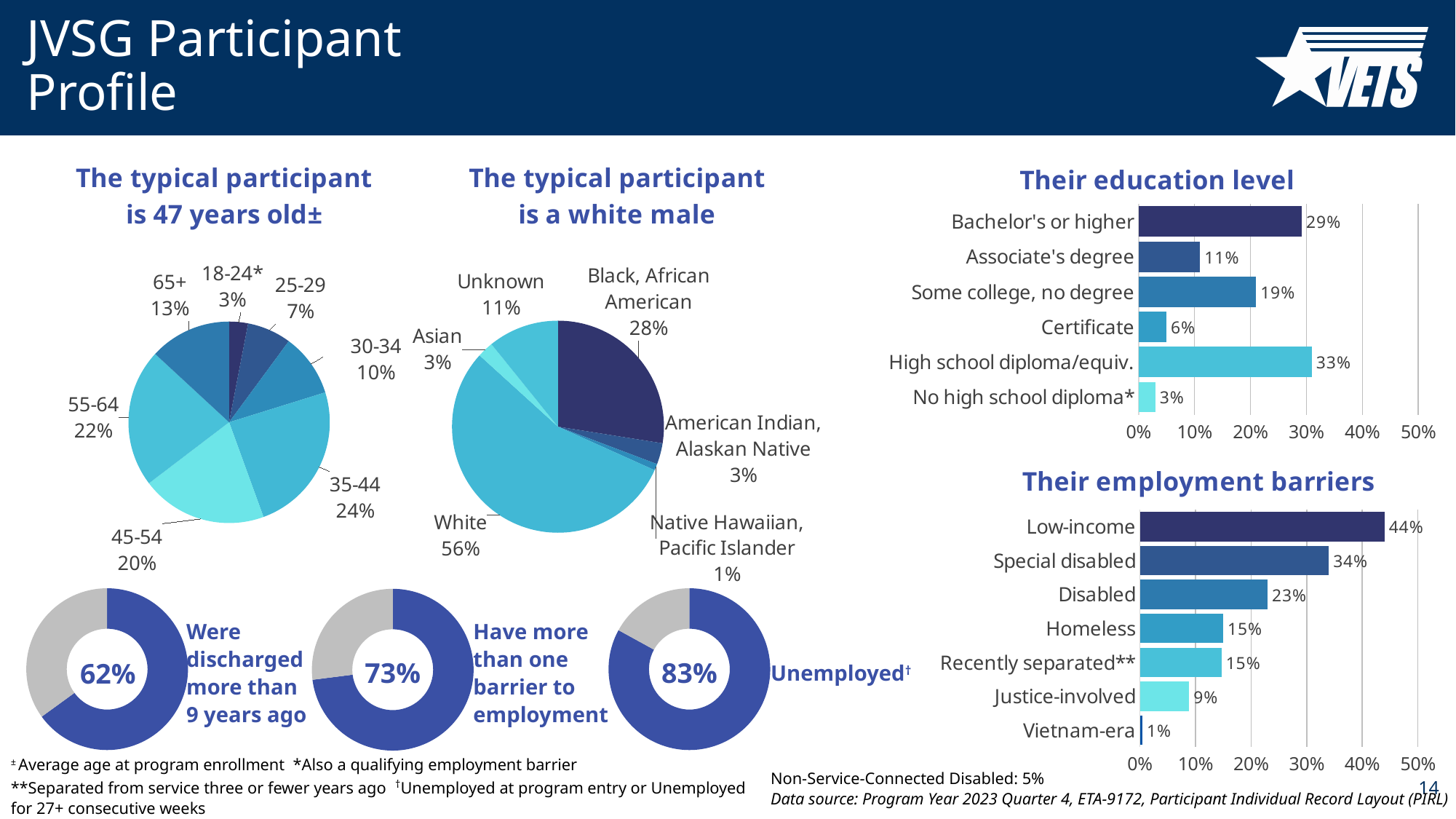
In the age pie chart, which age group has the smallest share? 18-24 In the age pie chart, how many age groups are shown? 7 In the race pie chart, what is the difference between the Black, African American share and the Unknown share? 17% In the "Their education level" chart, which category has the highest value? High school diploma/equiv. In the "Their employment barriers" chart, which is larger: Disabled or Homeless? Disabled In the race pie chart ("The typical participant is a white male"), what share of participants are White? 56% In the age pie chart ("The typical participant is 47 years old"), what share of participants are aged 35-44? 24% In the race pie chart, which category has the largest share? White What kind of chart is "Their employment barriers"? Bar chart In the donut chart labelled "Unemployed", what percentage is shown? 83% In the "Their employment barriers" chart, what is the value for Low-income? 44% In the "Their education level" chart, what is the value for Some college, no degree? 19%